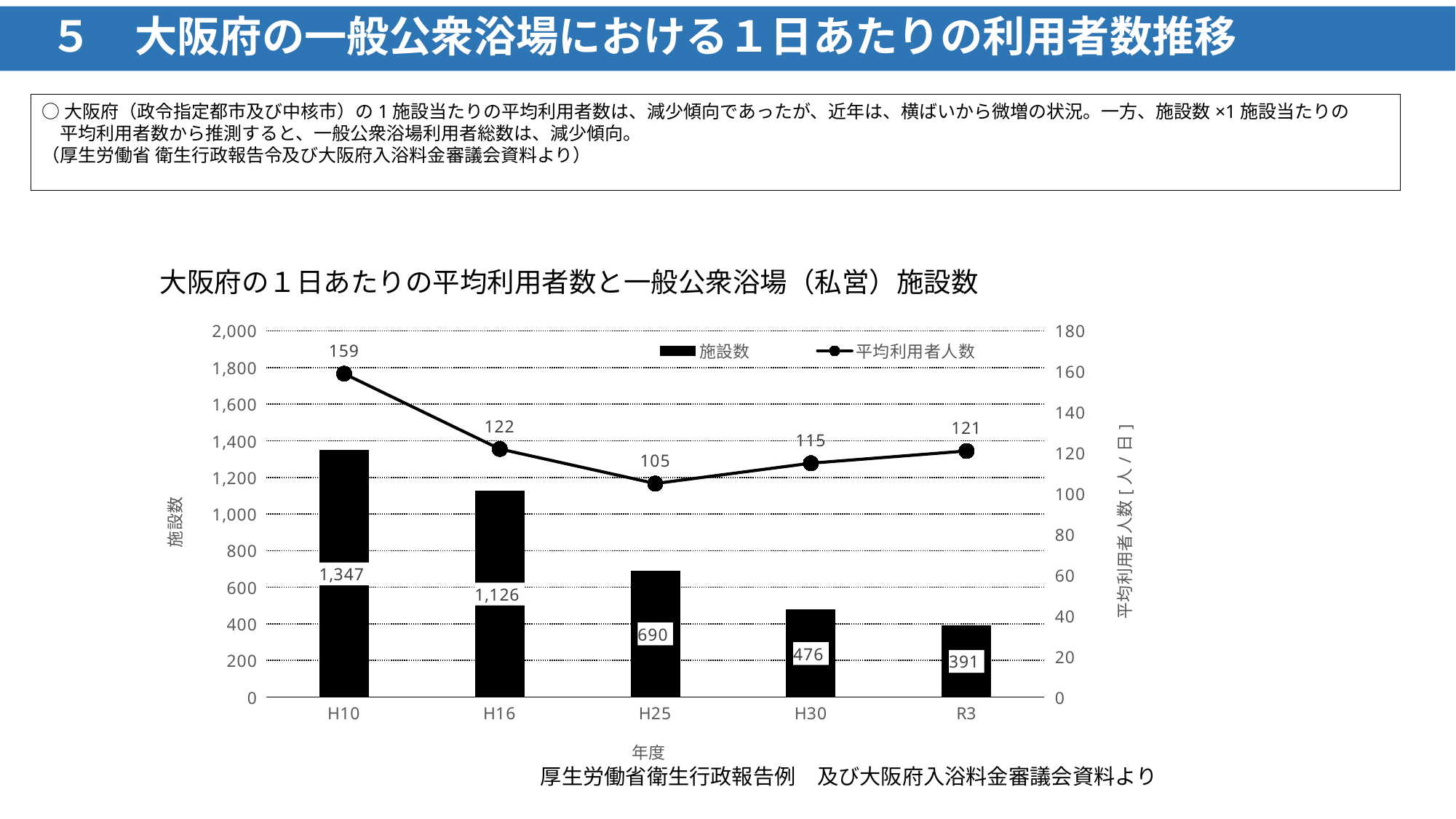
Which is larger, the 平均利用者人数 for H30 or for R3? R3 Which year has the lowest 平均利用者人数? H25 How many years are shown on the x axis? 5 What is the 施設数 value for H10? 1,347 Which year has the highest 施設数? H10 How many series does the legend list? 2 Does the 施設数 rise or fall from H10 to R3? Fall What is the 施設数 value for R3? 391 What kind of chart is this? Combined bar and line chart What is the title of the chart? 大阪府の１日あたりの平均利用者数と一般公衆浴場（私営）施設数 What is the difference in 施設数 between H16 and H25? 436 What is the 平均利用者人数 value for H25? 105